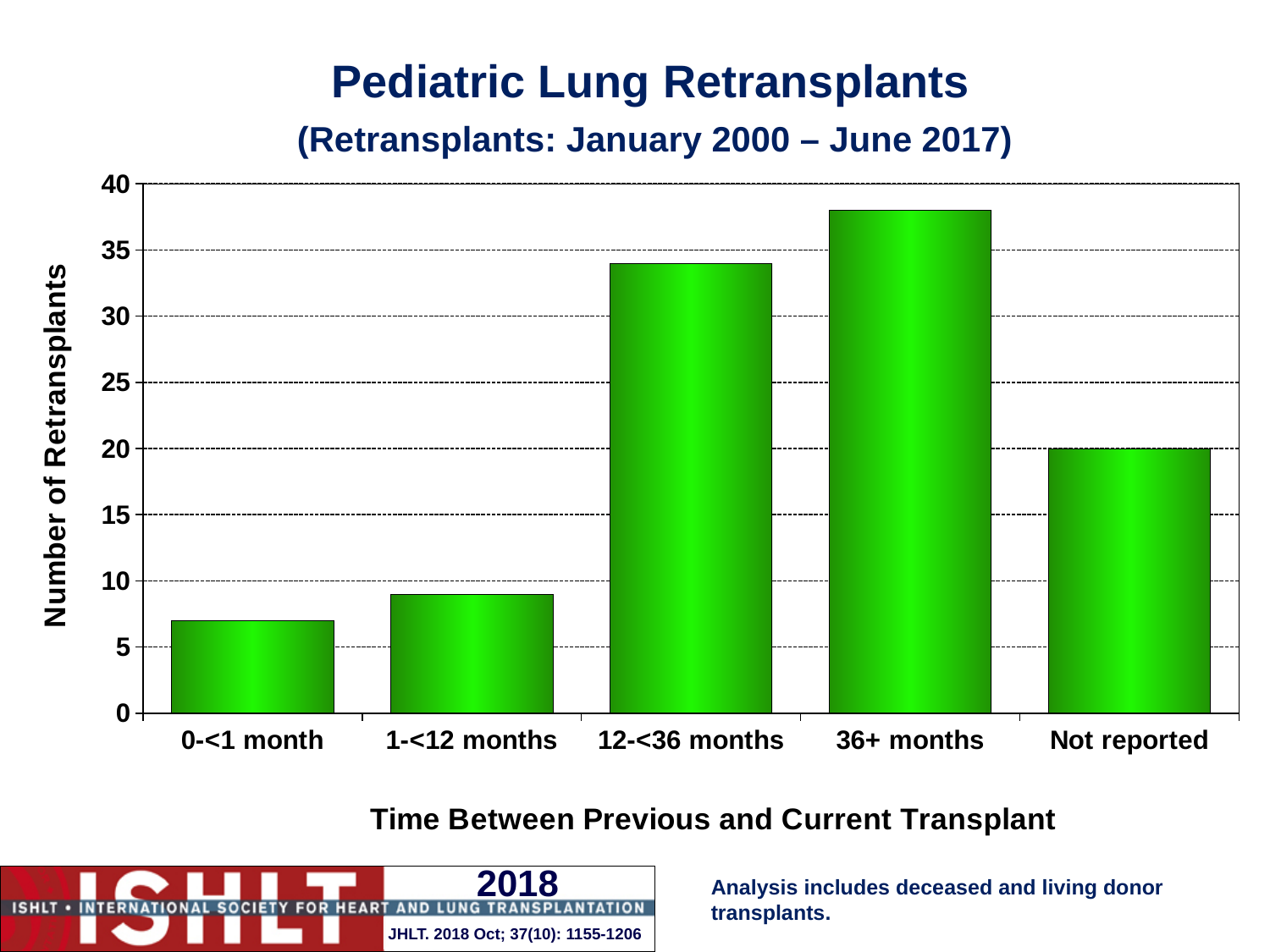
What kind of chart is shown on the slide? bar chart How many categories are shown on the x axis of the chart? 5 Which category has the highest number of retransplants? 36+ months Which is larger, the value for 12-<36 months or the value for Not reported? 12-<36 months What is the label of the y axis? Number of Retransplants Is the value for 0-<1 month greater or less than 10? less Is the value for 12-<36 months greater or less than 30? greater What is the label of the x axis? Time Between Previous and Current Transplant Is the value for 36+ months greater or less than 35? greater Which category has the lowest number of retransplants? 0-<1 month What is the number of retransplants for the Not reported category? 20